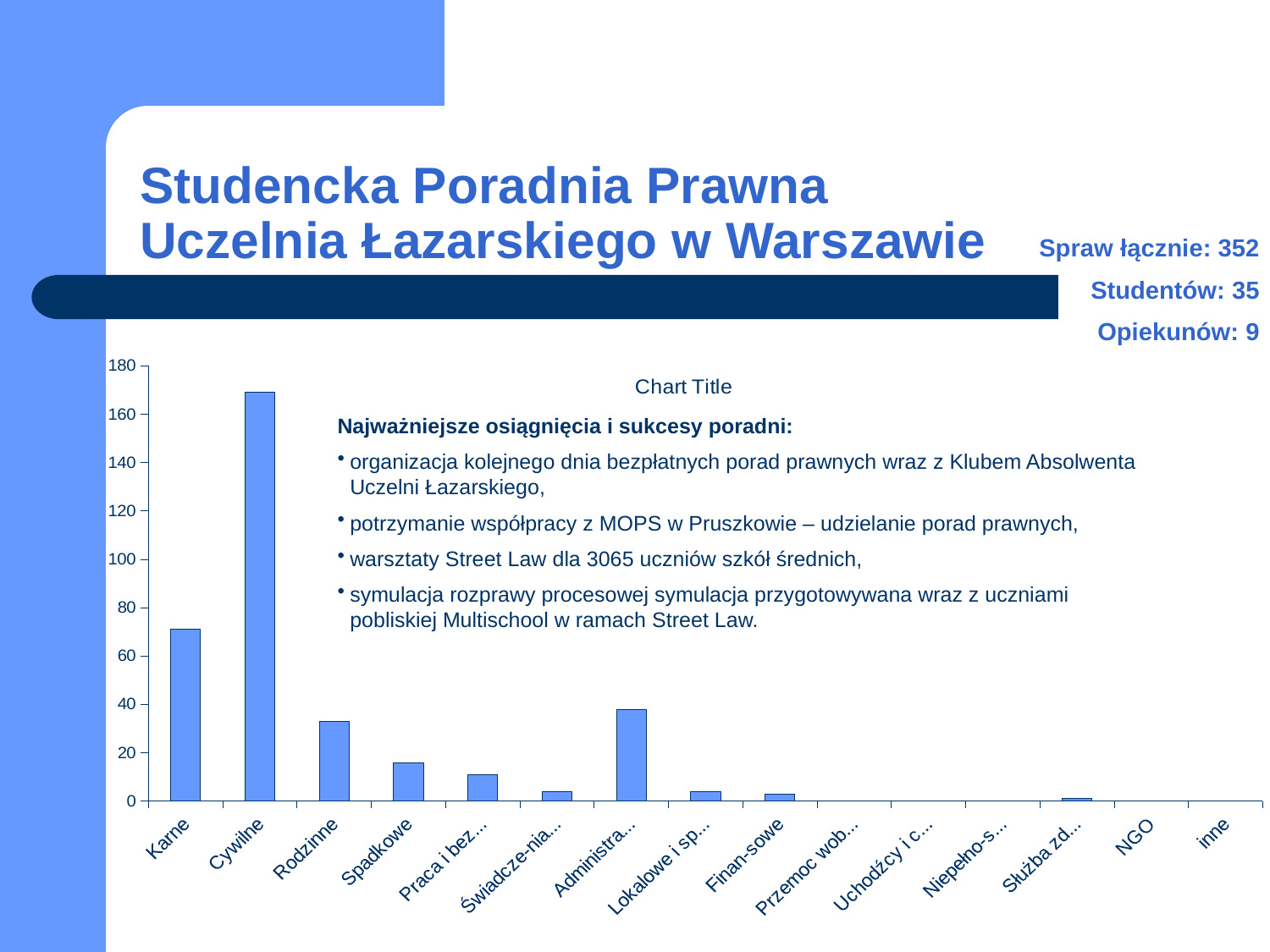
Is the value for Spadkowe greater or less than 20? less What is the highest value shown on the vertical axis of the chart? 180 Is the value for Rodzinne greater or less than 40? less What kind of chart is shown on the slide? bar chart Is the value for Cywilne greater or less than 160? greater Which is larger, the value for Karne or the value for Rodzinne? Karne Which is larger, the value for Spadkowe or the value for Administra...? Administra... What is the title printed on the chart? Chart Title How many categories are shown on the x axis of the chart? 15 Which category has the highest bar in the chart? Cywilne